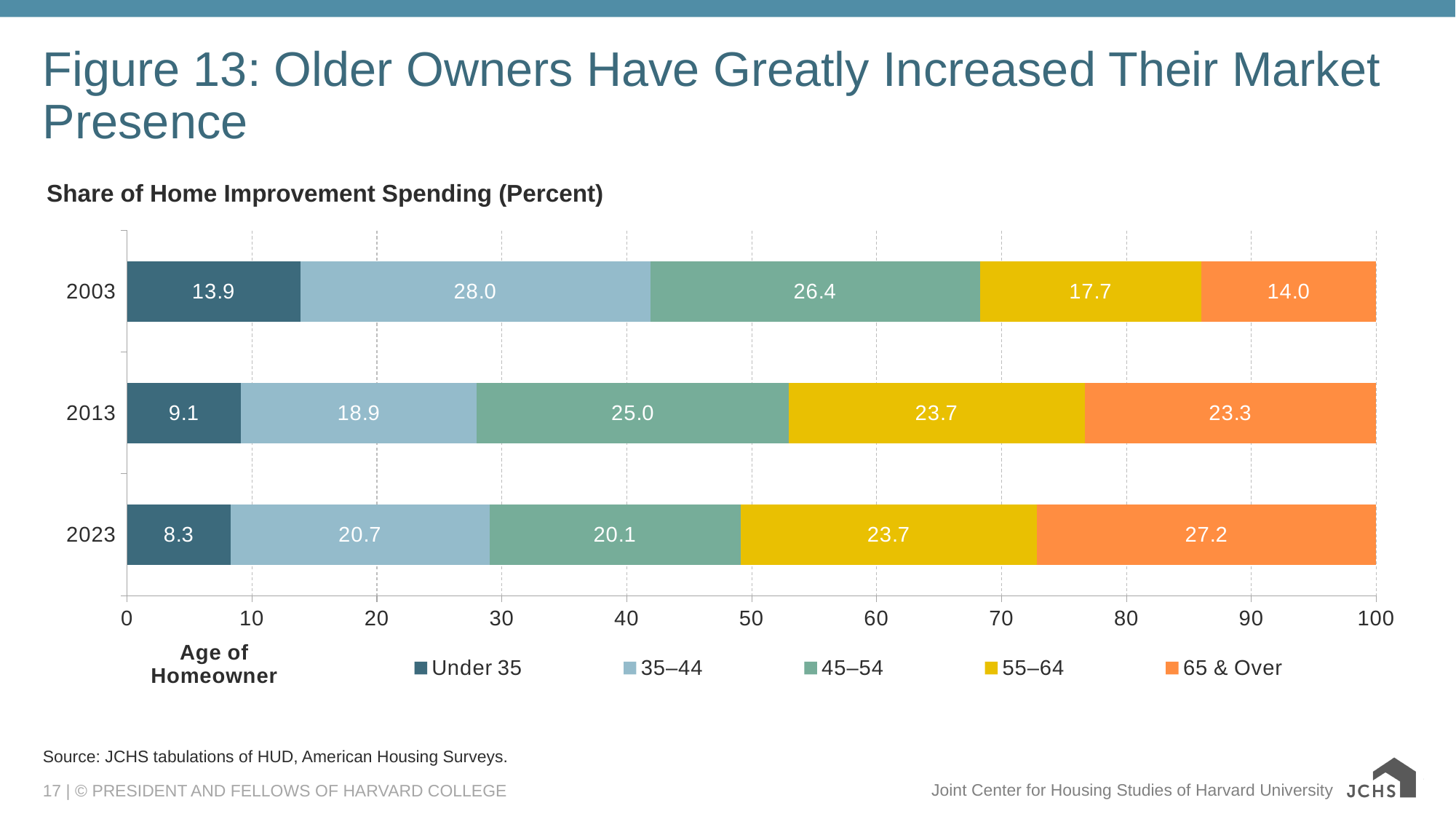
What kind of chart is shown on the slide? Stacked bar chart What share of home improvement spending did owners aged 65 & Over account for in 2023? 27.2 What share of spending did the 45–54 age group account for in 2013? 25.0 Which was larger in 2013: the share for 55–64 or the share for 65 & Over? 55–64 Which age group had the largest share of home improvement spending in 2003? 35–44 How many years are shown on the chart? 3 Which age group had the smallest share of home improvement spending in 2023? Under 35 What is the total of the stacked bar for 2013? 100.0 Does the share of spending for owners Under 35 rise or fall from 2003 to 2023? Fall How many age groups does the legend list? 5 By how many percentage points did the 65 & Over share change from 2003 to 2023? 13.2 What was the share of home improvement spending for owners Under 35 in 2003? 13.9